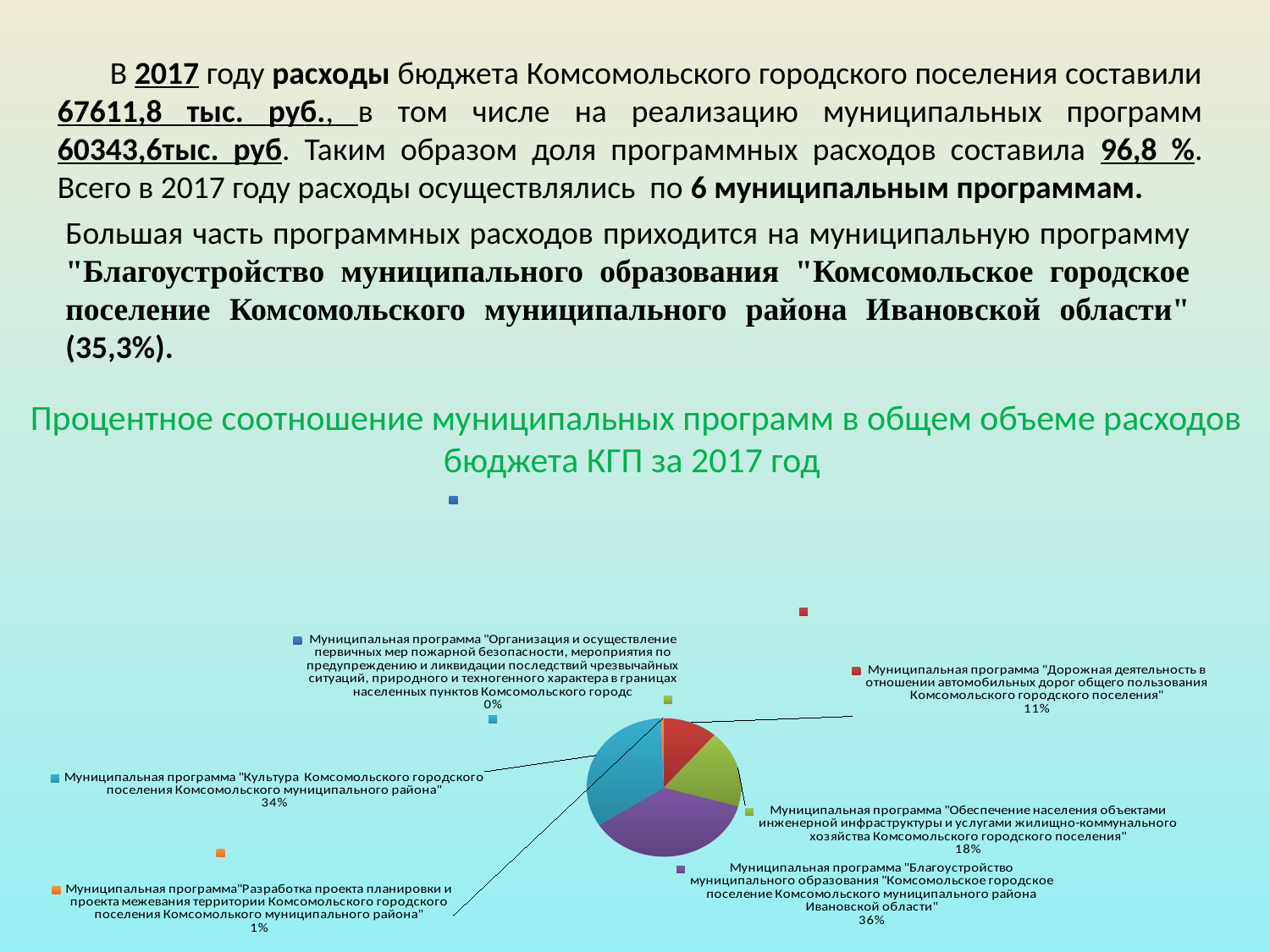
Which municipal programme has the largest share of the pie? Благоустройство муниципального образования "Комсомольское городское поселение Комсомольского муниципального района Ивановской области" (36%) What is the title of the pie chart? Процентное соотношение муниципальных программ в общем объеме расходов бюджета КГП за 2017 год What is the difference in percentage points between the share for the "Благоустройство" programme and the "Культура" programme? 2% What share is shown for the municipal programme "Обеспечение населения объектами инженерной инфраструктуры и услугами жилищно-коммунального хозяйства Комсомольского городского поселения"? 18% What share is shown for the municipal programme "Дорожная деятельность в отношении автомобильных дорог общего пользования Комсомольского городского поселения"? 11% What share is shown for the municipal programme "Разработка проекта планировки и проекта межевания территории Комсомольского городского поселения Комсомольского муниципального района"? 1% What share of the pie is labelled for the municipal programme "Благоустройство муниципального образования "Комсомольское городское поселение Комсомольского муниципального района Ивановской области""? 36% Which municipal programme has the smallest share of the pie? Организация и осуществление первичных мер пожарной безопасности... (0%) How many municipal programmes (slices) are labelled in the pie chart? 6 What share is shown for the municipal programme "Культура Комсомольского городского поселения Комсомольского муниципального района"? 34% Which share is larger: the "Дорожная деятельность" programme or the "Обеспечение населения объектами инженерной инфраструктуры" programme? Обеспечение населения объектами инженерной инфраструктуры (18%) What kind of chart is shown on the slide? pie chart